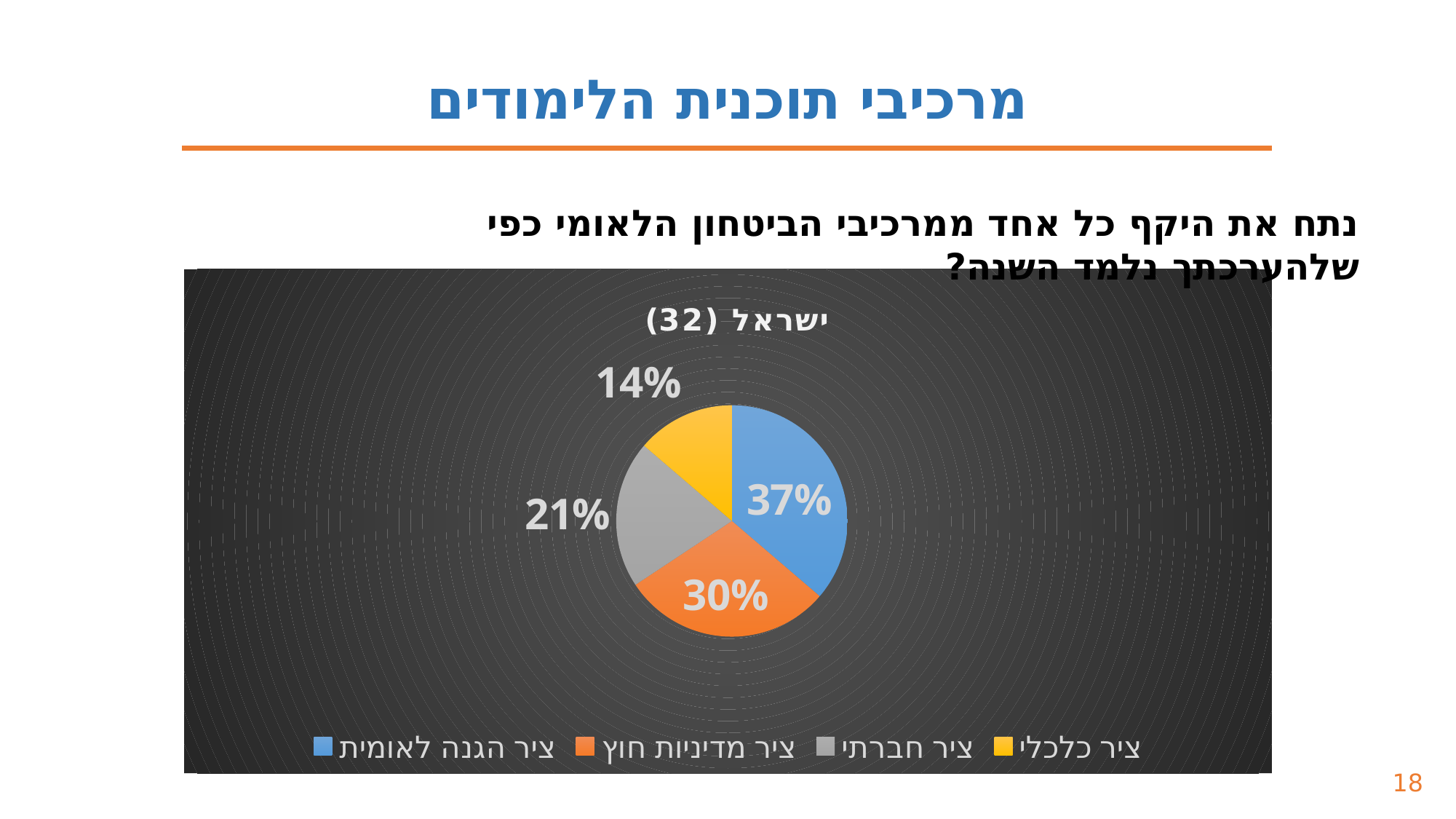
What percentage is shown for ציר מדיניות חוץ? 30% What percentage is shown for ציר כלכלי? 14% Which category has the smallest slice of the pie? ציר כלכלי How many slices does the pie chart have? 4 Which is larger, the slice for ציר חברתי or the slice for ציר כלכלי? ציר חברתי What is the title of the chart? ישראל (32) What kind of chart is shown on the slide? pie chart What percentage is shown for ציר הגנה לאומית? 37% What is the difference in percentage points between ציר הגנה לאומית and ציר מדיניות חוץ? 7 What colour is the slice for ציר מדיניות חוץ? orange Which category has the largest slice of the pie? ציר הגנה לאומית What percentage is shown for ציר חברתי? 21%